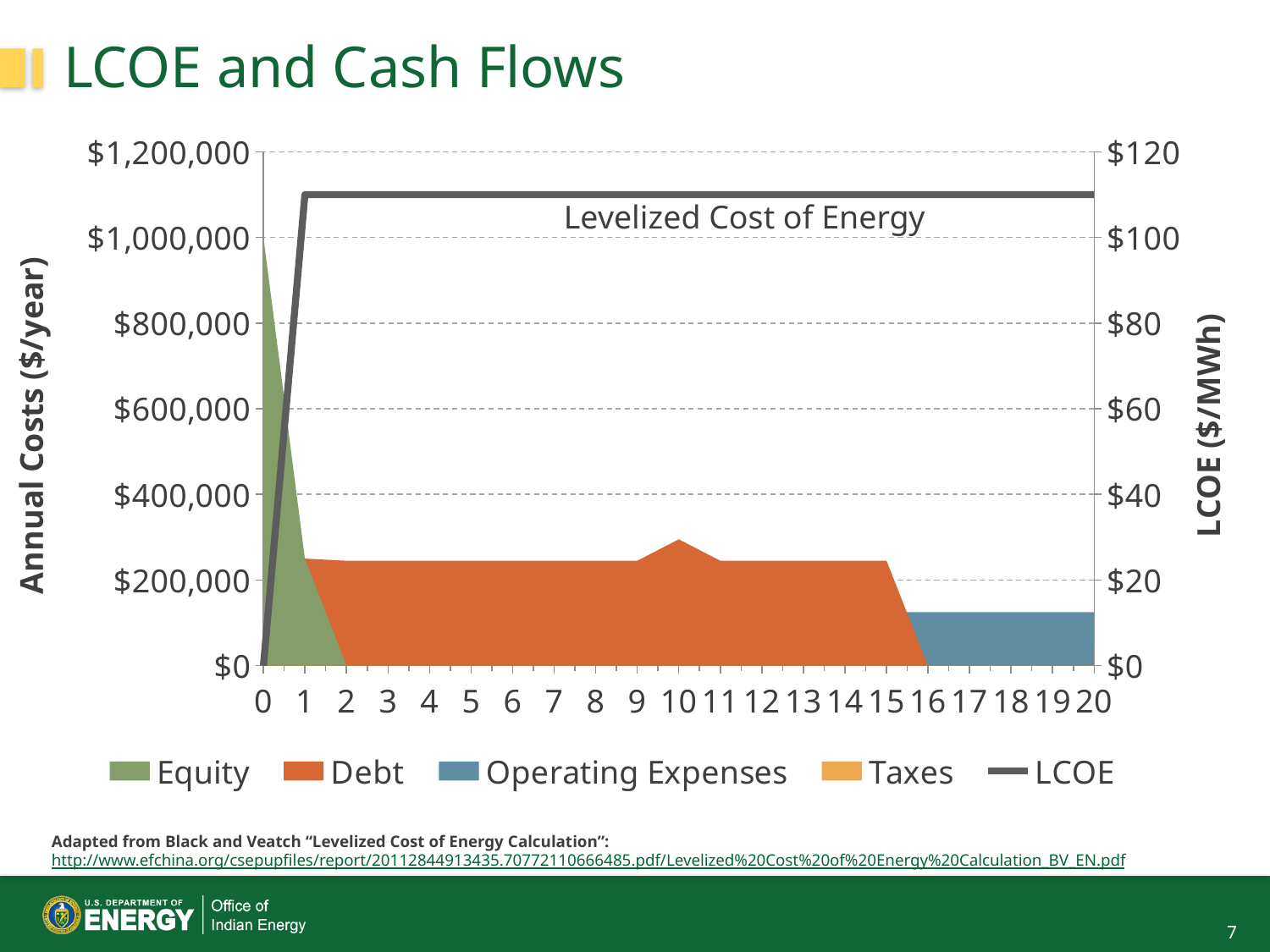
What is the label of the right-hand vertical axis? LCOE ($/MWh) Is the Debt value at year 10 greater or less than $400,000? less Is the Debt value at year 5 greater or less than $200,000? greater Is the Equity value at year 0 greater or less than $800,000? greater How many series does the legend list? 5 What is the title of the slide's chart area as labeled on the plot? Levelized Cost of Energy Which is larger: the Equity value at year 0 or the Debt value at year 5? Equity at year 0 Which series reaches the highest annual cost on the chart? Equity Does the Equity series rise or fall from year 0 to year 2? fall Does the LCOE line rise, fall, or stay flat from year 1 to year 20? stays flat